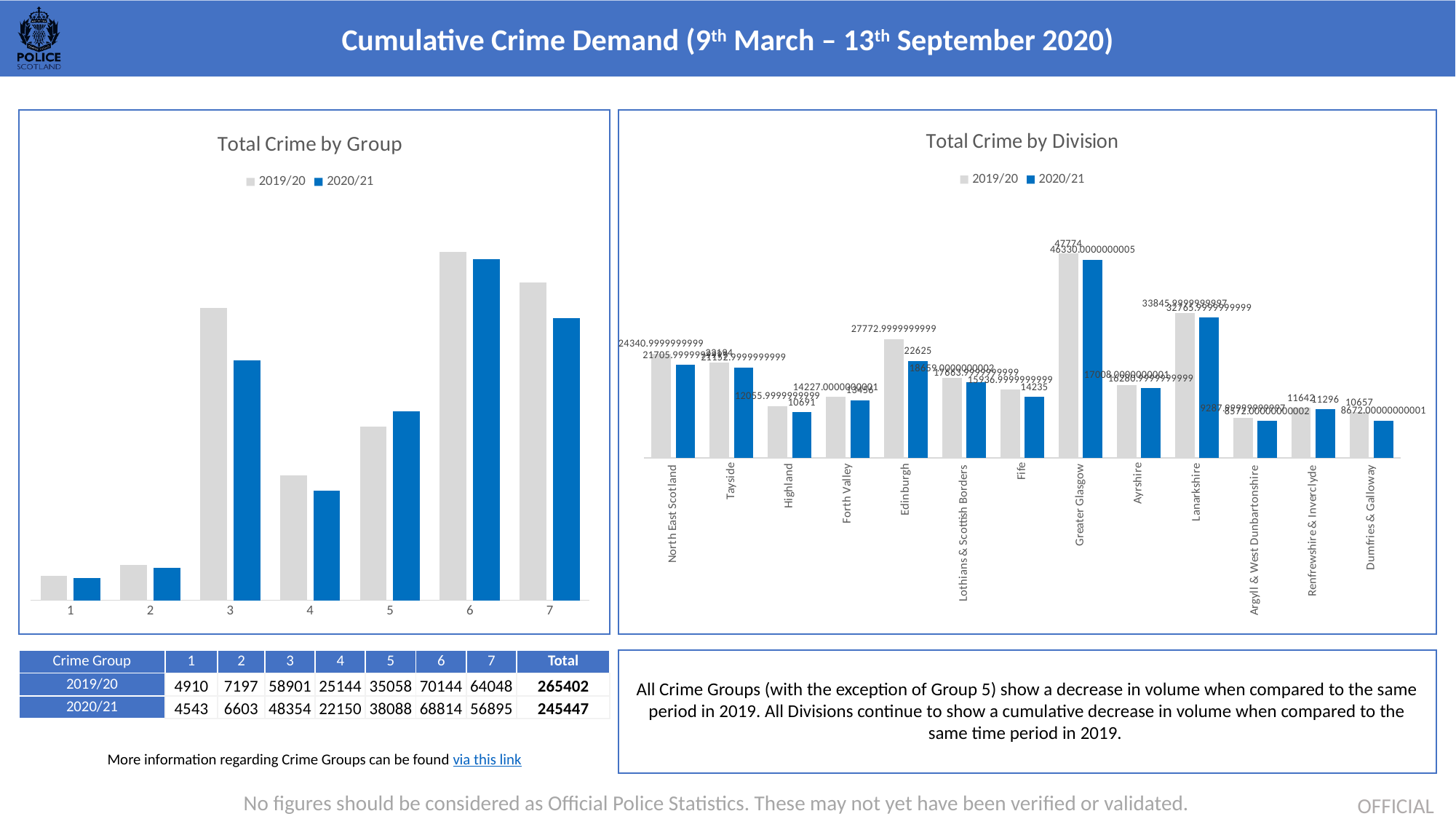
How many divisions are shown on the x axis of the "Total Crime by Division" chart? 13 What is the difference between the 2019/20 and 2020/21 values for crime group 6 in the "Total Crime by Group" chart? 1330 What is the 2020/21 value for crime group 3 in the "Total Crime by Group" chart? 48354 What kind of chart is the "Total Crime by Group" chart? bar chart How many series does the legend of the "Total Crime by Division" chart list? 2 How many crime groups are shown on the x axis of the "Total Crime by Group" chart? 7 In the "Total Crime by Group" chart, which crime group has the lowest value for 2020/21? 1 What is the 2019/20 value for Greater Glasgow in the "Total Crime by Division" chart? 47774 In the "Total Crime by Group" chart, is the 2020/21 bar for group 5 higher or lower than the 2019/20 bar? higher In the "Total Crime by Group" chart, which crime group has the highest value for 2019/20? 6 What is the 2020/21 value for Edinburgh in the "Total Crime by Division" chart? 22625 In the "Total Crime by Division" chart, which division has the highest value for 2019/20? Greater Glasgow